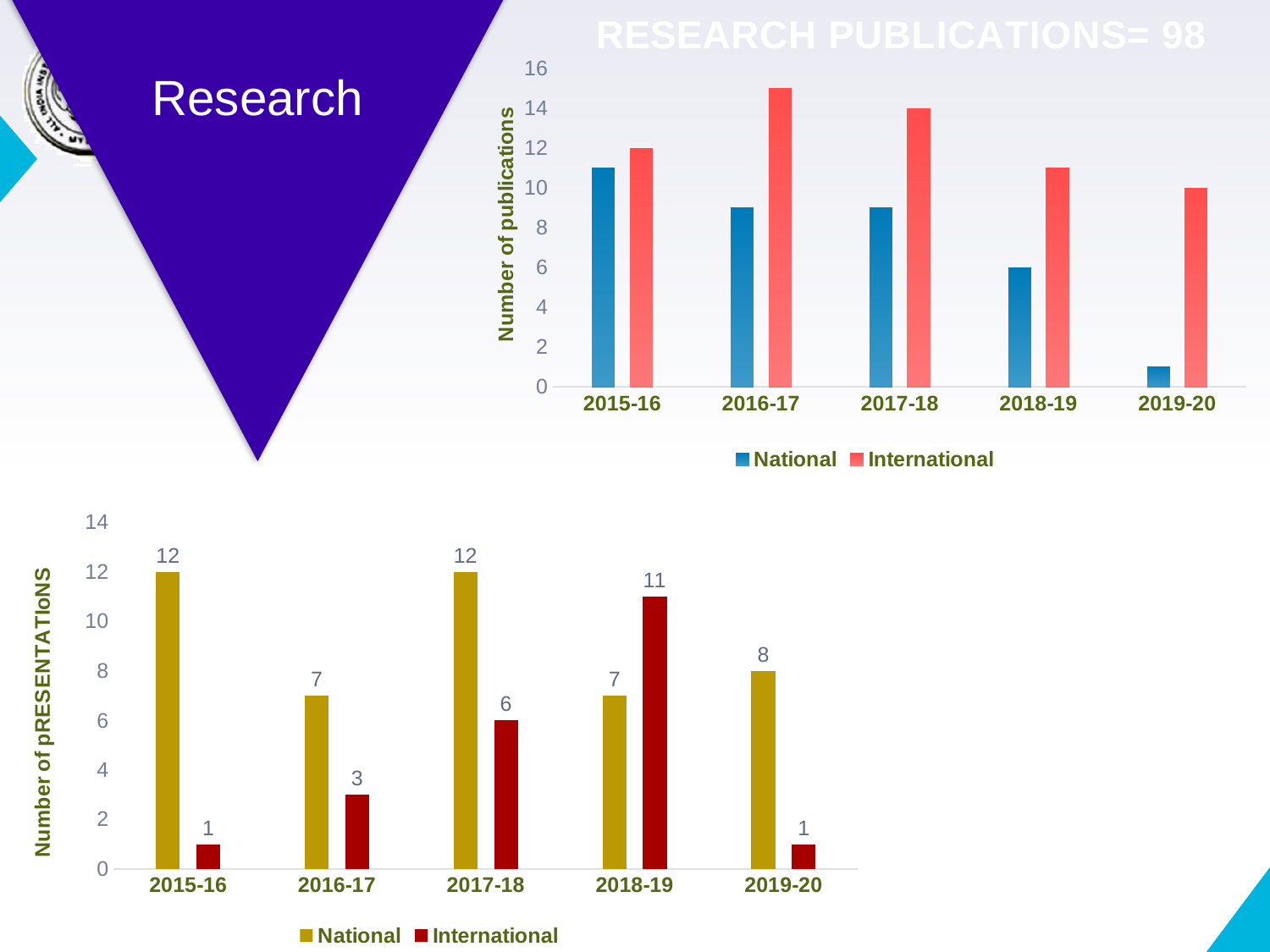
In the top chart (Research Publications), which year has the highest International value? 2016-17 In the top chart (Research Publications), how many series does the legend list? 2 What kind of chart is the top chart (Research Publications)? Bar chart In the bottom chart (Number of presentations), how many years are shown on the x axis? 5 In the top chart (Research Publications), which year has the lowest National value? 2019-20 In the top chart (Research Publications), is the National value for 2016-17 greater or less than 8? greater What total is stated in the title of the top chart? 98 In the bottom chart (Number of presentations), which year has the highest International value? 2018-19 In the bottom chart (Number of presentations), which is larger for 2018-19, National or International? International In the bottom chart (Number of presentations), what is the International value for 2018-19? 11 In the bottom chart (Number of presentations), what is the difference between the National and International values for 2016-17? 4 In the bottom chart (Number of presentations), what is the National value for 2015-16? 12